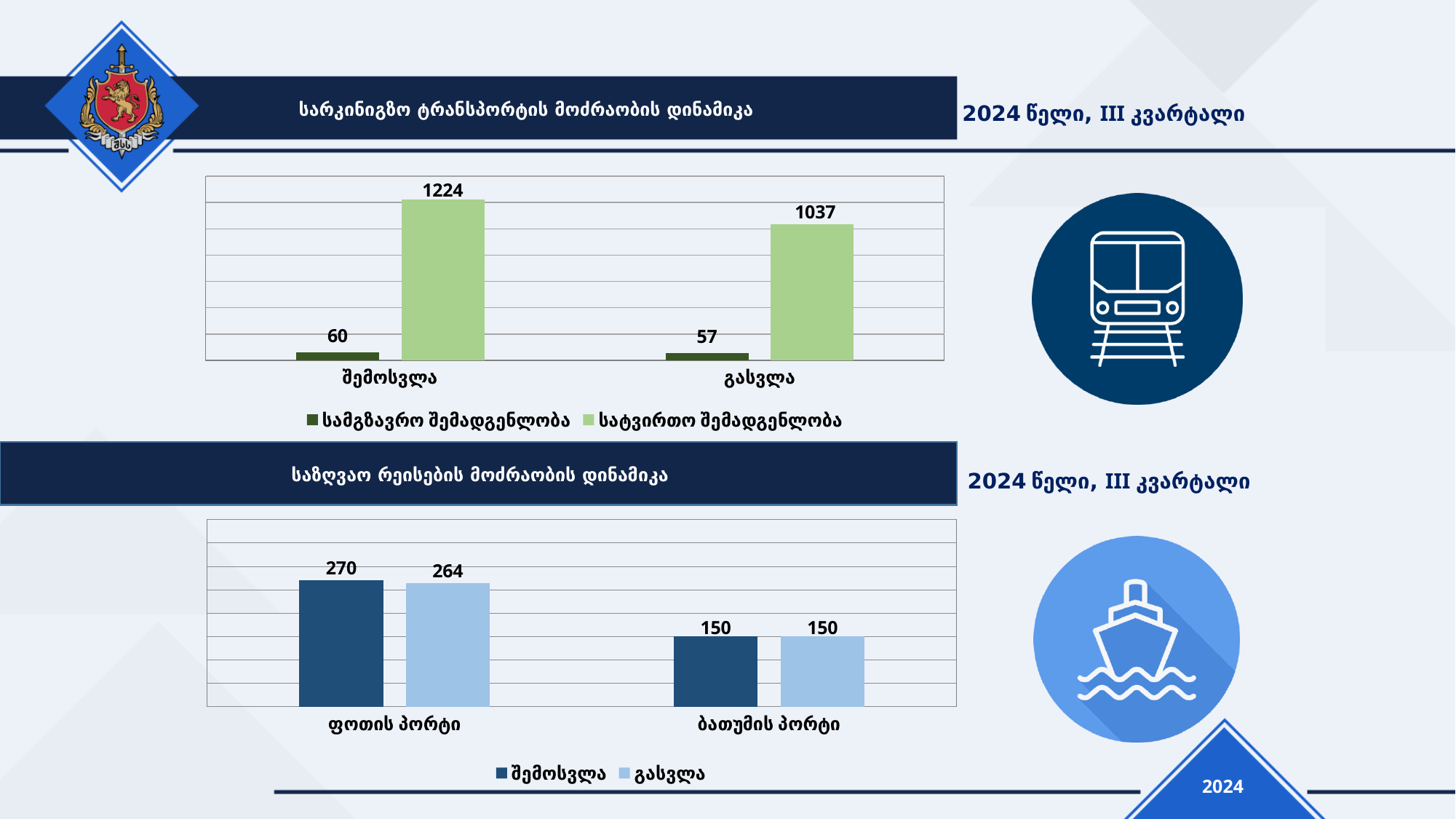
In the top chart, how many series does the legend list? 2 In the bottom chart (საზღვაო რეისების მოძრაობის დინამიკა), what is the შემოსვლა value for ფოთის პორტი? 270 In the bottom chart, what is the გასვლა value for ბათუმის პორტი? 150 In the top chart, which category has the higher სატვირთო შემადგენლობა value? შემოსვლა In the top chart, what is the difference between the სატვირთო შემადგენლობა values for შემოსვლა and გასვლა? 187 In the top chart (სარკინიგზო ტრანსპორტის მოძრაობის დინამიკა), what is the value of სატვირთო შემადგენლობა for შემოსვლა? 1224 In the bottom chart, how many categories are shown on the x axis? 2 What type of chart is the top chart on the slide? Bar chart In the top chart, what is the value of სამგზავრო შემადგენლობა for გასვლა? 57 In the bottom chart, which port has the lower შემოსვლა value? ბათუმის პორტი In the bottom chart, which series is shown in light blue? გასვლა In the bottom chart, what is the difference between შემოსვლა and გასვლა for ფოთის პორტი? 6